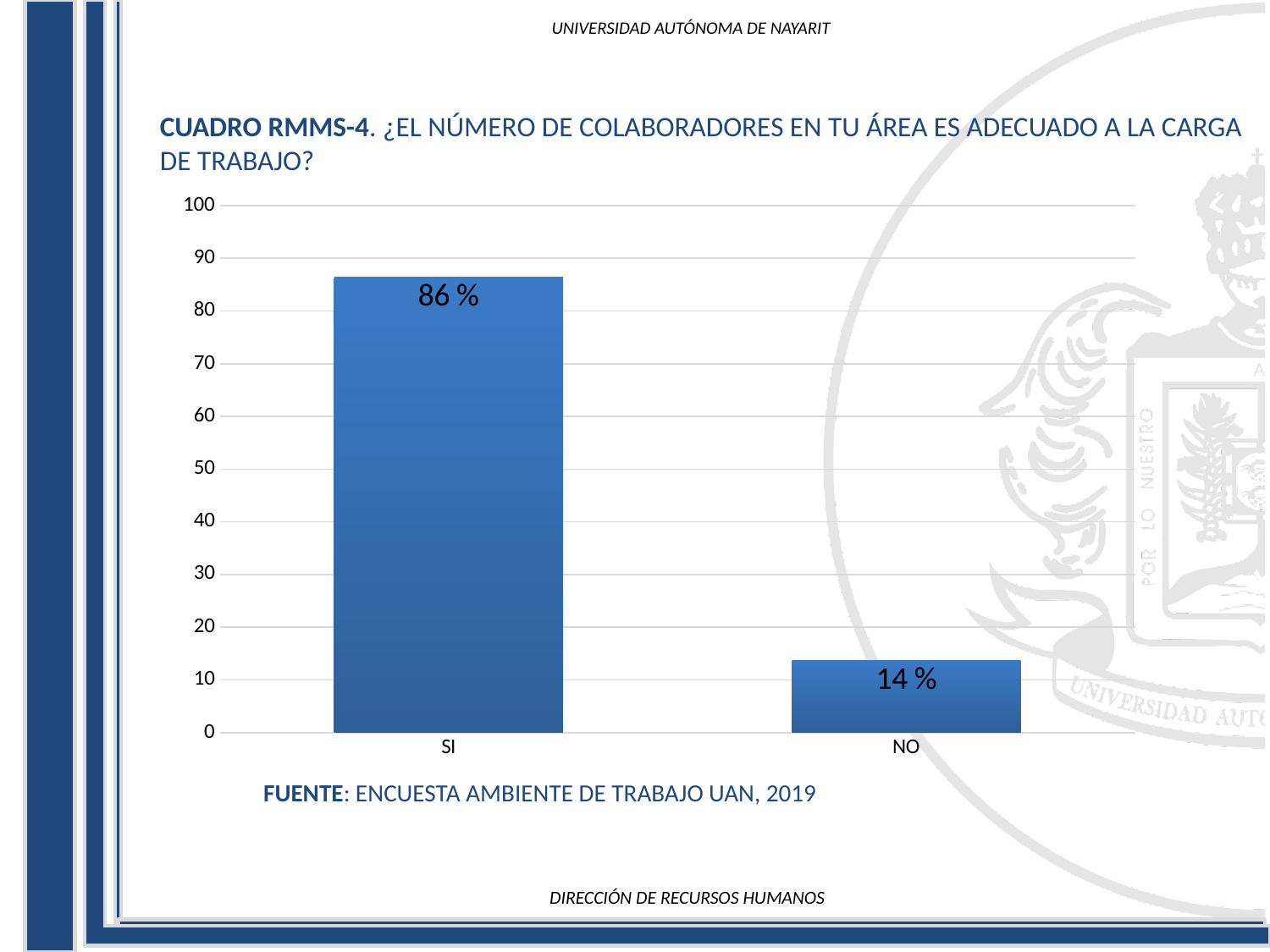
What is the source cited below the chart? ENCUESTA AMBIENTE DE TRABAJO UAN, 2019 What is the value for NO? 14 % What is the maximum value shown on the y axis? 100 Is the value for SI greater or less than 80? greater How many categories are shown on the x axis? 2 Which category has the lowest value? NO What is the difference between the values for SI and NO? 72 % Which category has the highest value? SI What kind of chart is shown on the slide? bar chart Which is larger, the value for SI or the value for NO? SI Is the value for NO greater or less than 20? less What is the value for SI? 86 %